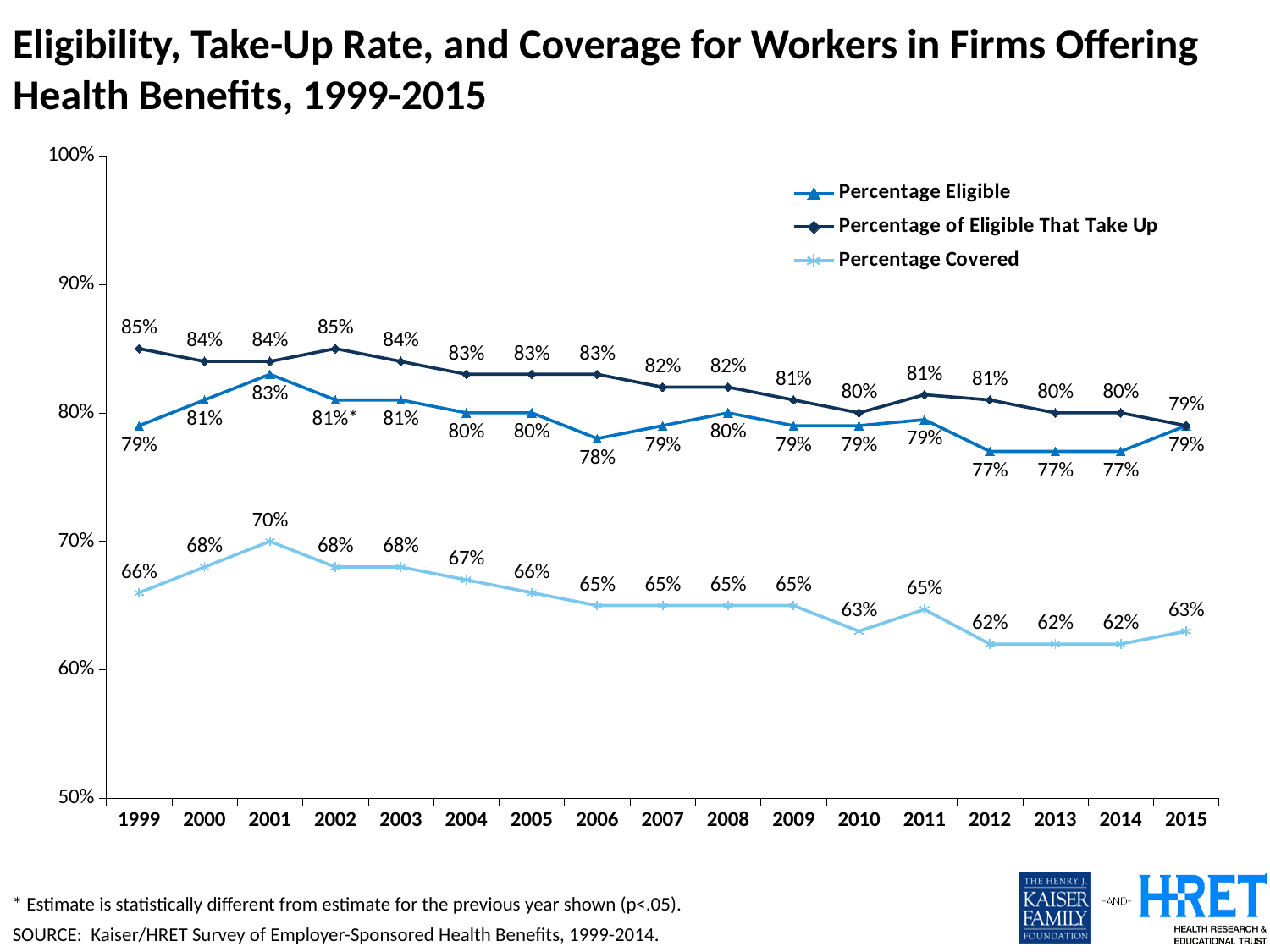
Which series is marked with star-shaped markers in the legend? Percentage Covered What type of chart is shown on the slide? Line chart Which is larger in 2011: Percentage Eligible or Percentage Covered? Percentage Eligible In which year is the Percentage Covered series at its highest? 2001 How many years are plotted along the x axis? 17 How many series does the legend list? 3 What is the Percentage Covered value for 2001? 70% What is the difference between the Percentage of Eligible That Take Up and the Percentage Eligible in 1999? 6% In which year is the Percentage of Eligible That Take Up series at its lowest? 2015 What is the Percentage of Eligible That Take Up value for 1999? 85% Does the Percentage Covered series generally rise or fall from 2001 to 2014? Fall What is the Percentage Eligible value for 2006? 78%